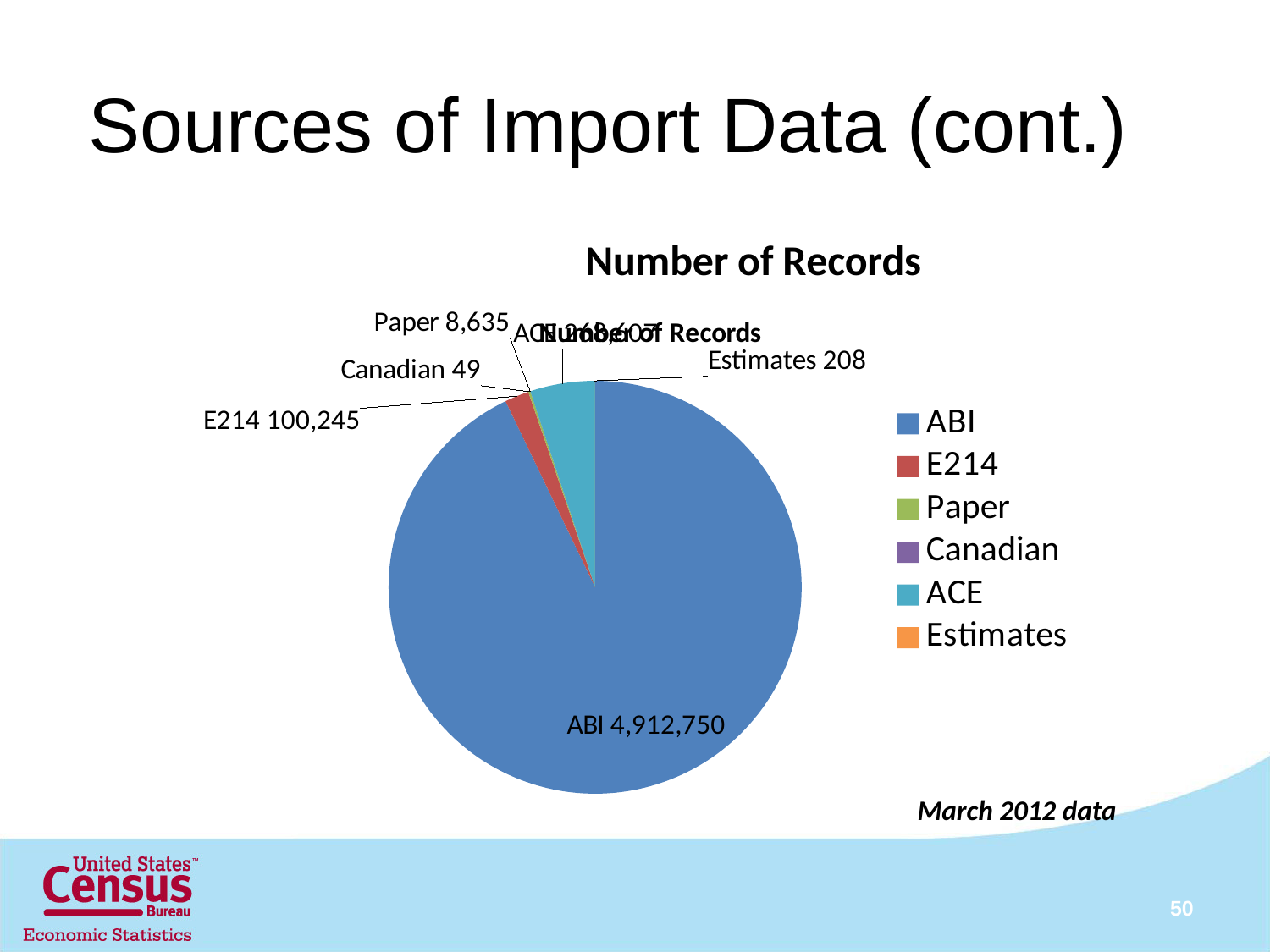
Which source has the smallest number of records? Canadian What is the number of records for Paper? 8,635 What is the number of records for Canadian? 49 Which source has the largest number of records? ABI What kind of chart is shown on the slide? pie chart What is the difference between the number of records for E214 and for Paper? 91,610 What is the number of records for ABI? 4,912,750 How many categories does the legend list? 6 What is the title of the chart? Number of Records What is the number of records for E214? 100,245 Which has more records, E214 or Paper? E214 What is the number of records for Estimates? 208